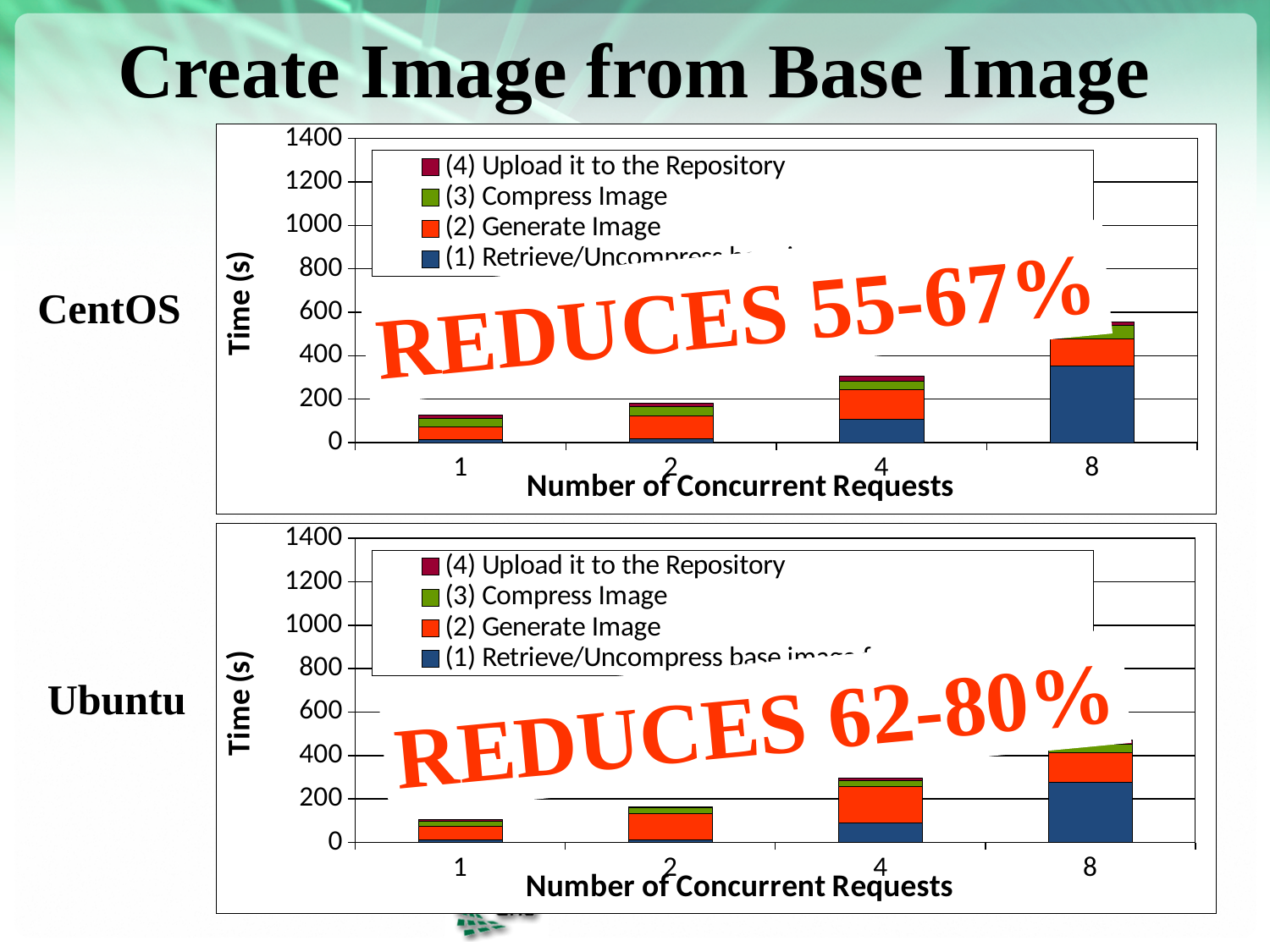
What is the y-axis title of the Ubuntu chart? Time (s) In the Ubuntu chart, which number of concurrent requests has the lowest total time? 1 In the Ubuntu chart, does the total time rise or fall as the number of concurrent requests increases? rise In the Ubuntu chart, is the total time for 8 concurrent requests greater or less than 200? greater In the CentOS chart, which has the larger total time: 2 concurrent requests or 4 concurrent requests? 4 In the CentOS chart, is the total time for 1 concurrent request greater or less than 200? less In the Ubuntu chart, is the total time for 4 concurrent requests greater or less than 400? less In the CentOS chart, which number of concurrent requests has the highest total time? 8 What kind of chart is the top (CentOS) chart? stacked bar chart In the CentOS chart, how many categories are shown on the x axis? 4 In the Ubuntu chart, how many series does the legend list? 4